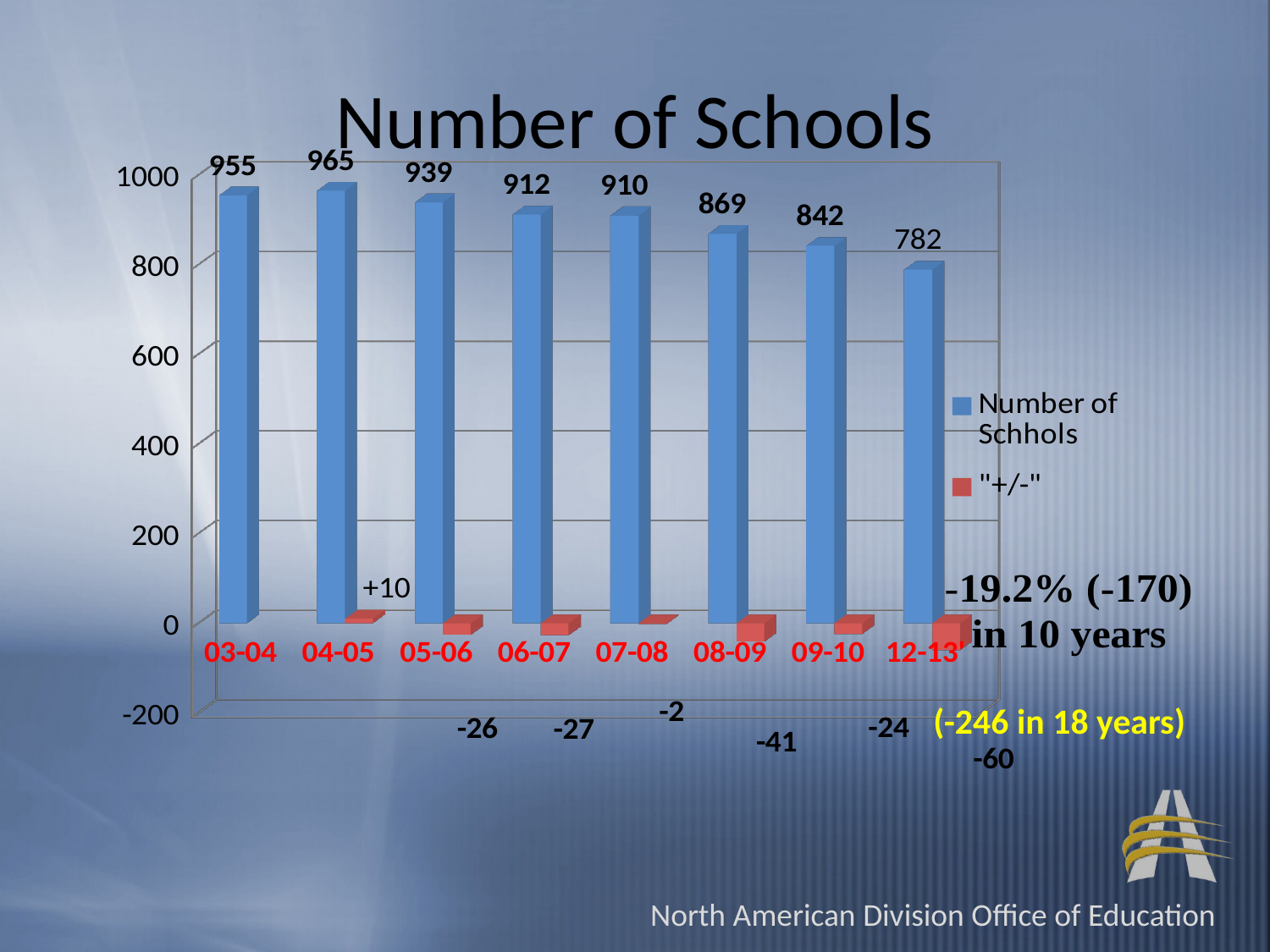
What is the number of schools for 12-13? 782 What is the difference between the number of schools in 03-04 and 12-13? 173 Does the number of schools generally rise or fall from 04-05 to 12-13? fall Which year has the highest number of schools? 04-05 What is the number of schools for 04-05? 965 What is the "+/-" value for 08-09? -41 How many year categories are shown on the x axis? 8 What kind of chart is shown on the slide? bar chart Which year has the lowest number of schools? 12-13 Which year has more schools, 06-07 or 09-10? 06-07 Is the number of schools for 09-10 greater or less than 800? greater How many series does the legend list? 2